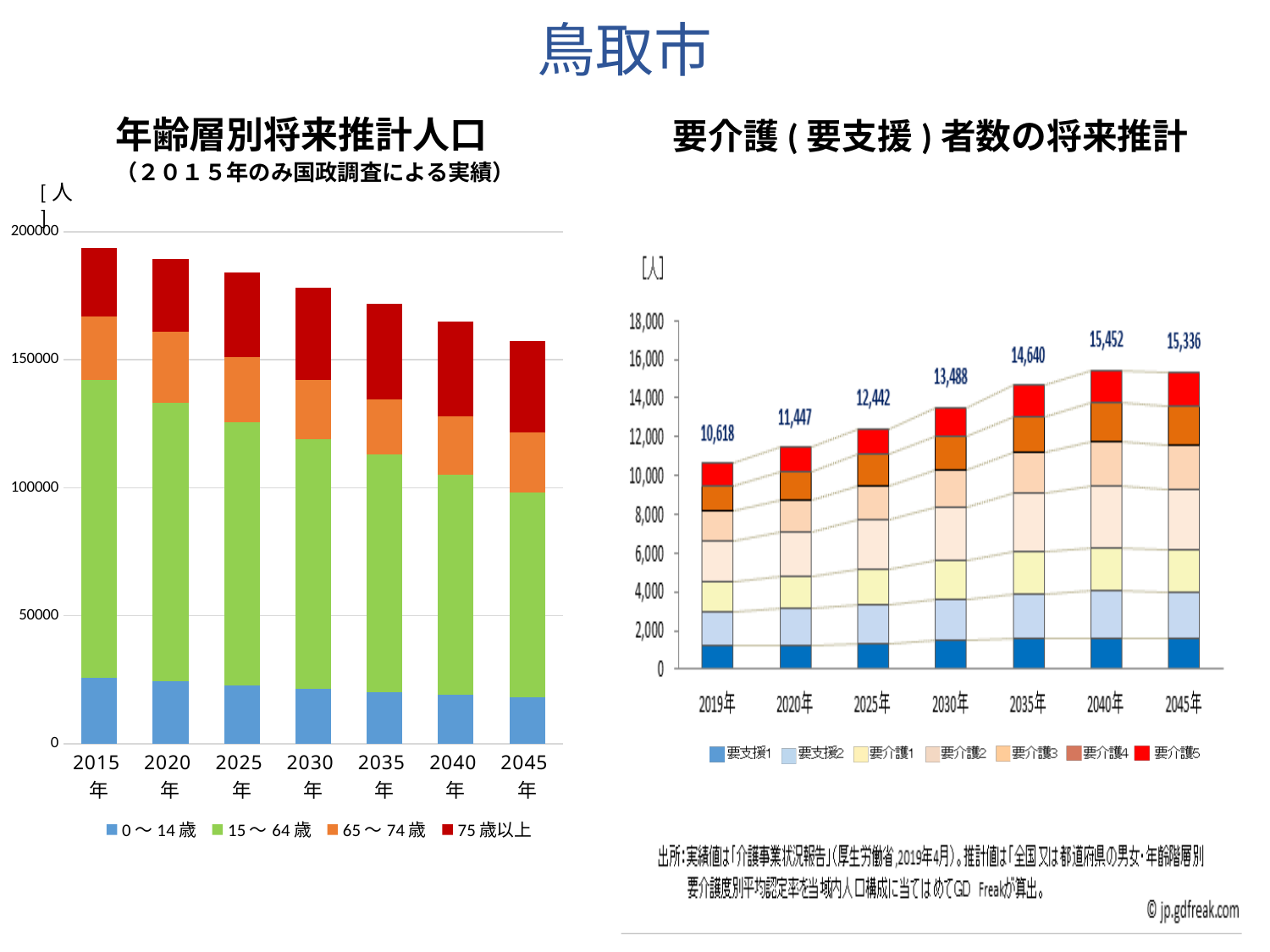
In the right chart (要介護(要支援)者数の将来推計), which year has the lowest total? 2019年 In the right chart (要介護(要支援)者数の将来推計), what is the total number shown for 2030年? 13,488 What kind of chart is the left chart (年齢層別将来推計人口)? Stacked bar chart In the left chart (年齢層別将来推計人口), how many years are shown on the x axis? 7 In the right chart (要介護(要支援)者数の将来推計), what is the total number shown for 2040年? 15,452 In the right chart (要介護(要支援)者数の将来推計), by how much does the total for 2045年 exceed the total for 2019年? 4,718 In the right chart (要介護(要支援)者数の将来推計), how many series does the legend list? 7 In the left chart (年齢層別将来推計人口), does the total population rise or fall from 2015年 to 2045年? Fall In the left chart (年齢層別将来推計人口), how many series does the legend list? 4 In the right chart (要介護(要支援)者数の将来推計), what is the difference between the totals for 2040年 and 2045年? 116 In the right chart (要介護(要支援)者数の将来推計), which year has the highest total? 2040年 In the left chart (年齢層別将来推計人口), is the total for 2015年 greater or less than 150000? greater